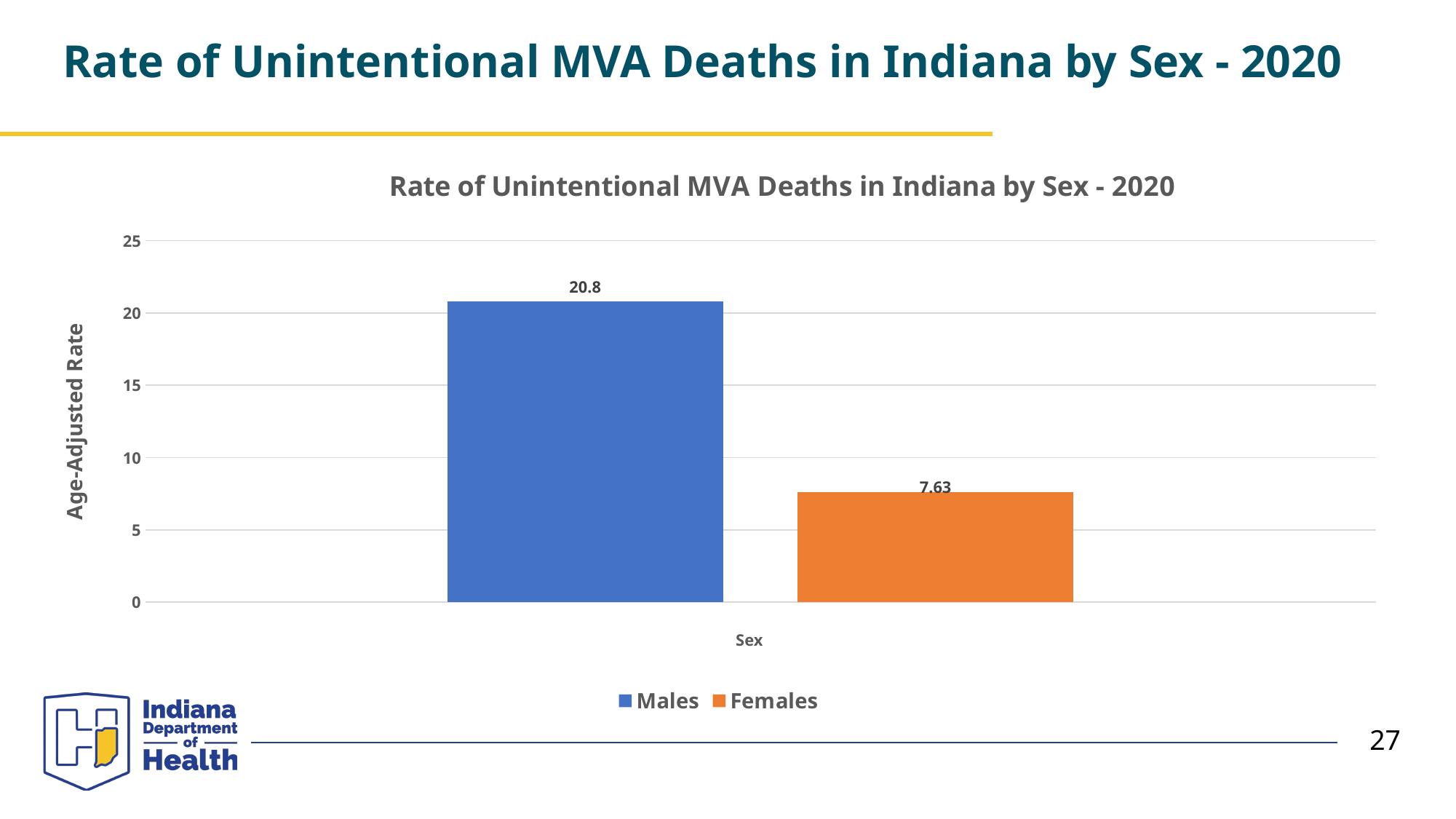
What is the age-adjusted rate of unintentional MVA deaths for Females? 7.63 How many series does the legend list? 2 Which sex has the higher rate of unintentional MVA deaths? Males What is the highest value shown on the vertical axis? 25 Is the rate for Males greater or less than 20? greater What kind of chart is shown on the slide? Bar chart What is the difference between the Males rate and the Females rate? 13.17 What is the age-adjusted rate of unintentional MVA deaths for Males? 20.8 Which sex has the lower rate of unintentional MVA deaths? Females Is the rate for Females greater or less than 10? less What colour is the bar for Females? Orange What is the label of the vertical axis? Age-Adjusted Rate